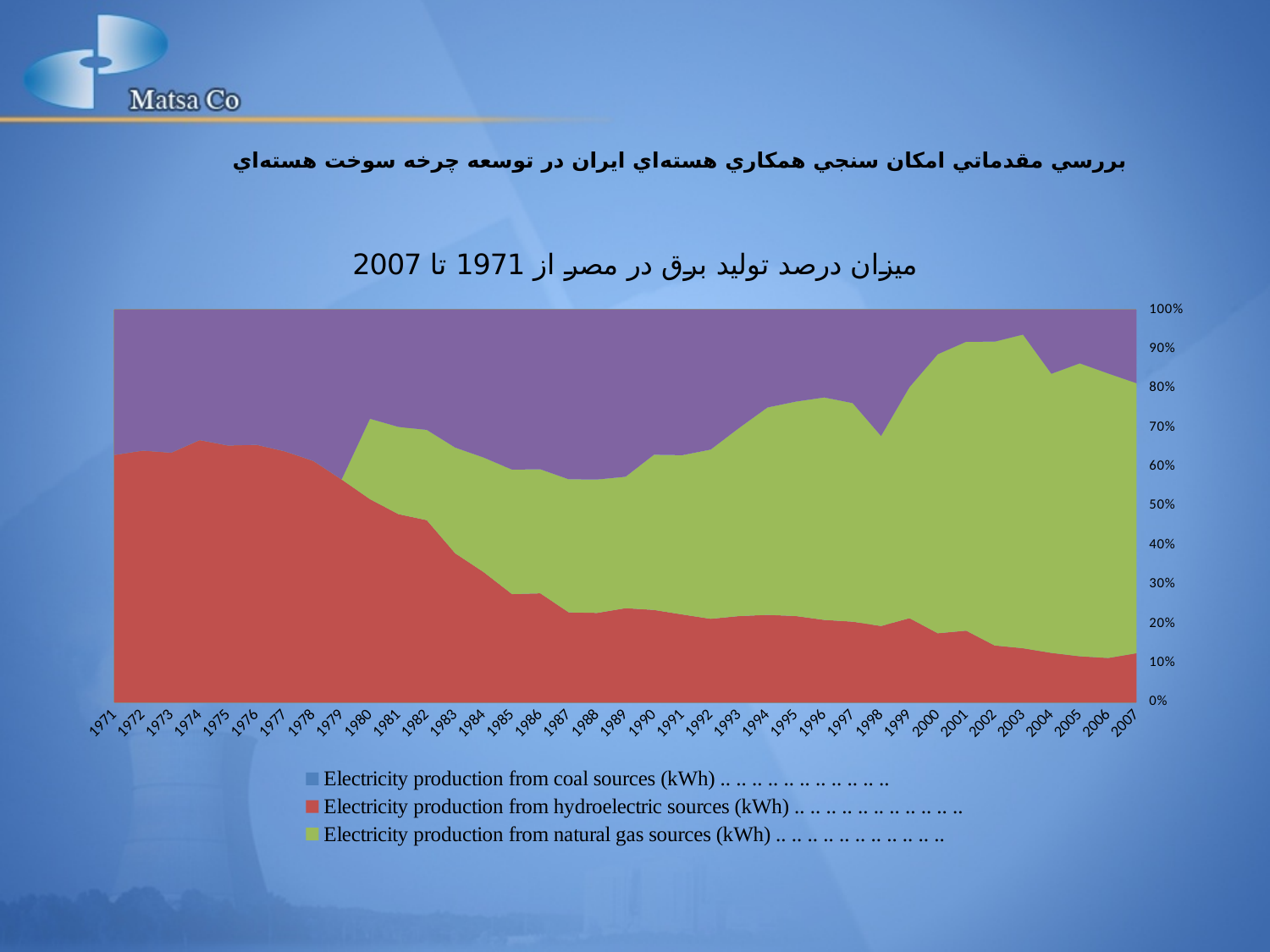
Is the share of electricity production from hydroelectric sources in 1990 greater or less than 30%? less Which colour represents electricity production from hydroelectric sources in the legend? Red What is the last year shown on the x axis? 2007 Is the share of electricity production from hydroelectric sources in 1971 greater or less than 60%? greater Which colour represents electricity production from natural gas sources in the legend? Green What is the first year shown on the x axis? 1971 What kind of chart is shown on the slide? Area chart Which is larger: the hydroelectric share in 1971 or the hydroelectric share in 2007? 1971 How many series does the legend list? 3 Is the share of electricity production from hydroelectric sources in 2007 greater or less than 20%? less Does the share of electricity production from hydroelectric sources rise or fall from 1971 to 2007? Fall How many years are shown along the x axis? 37